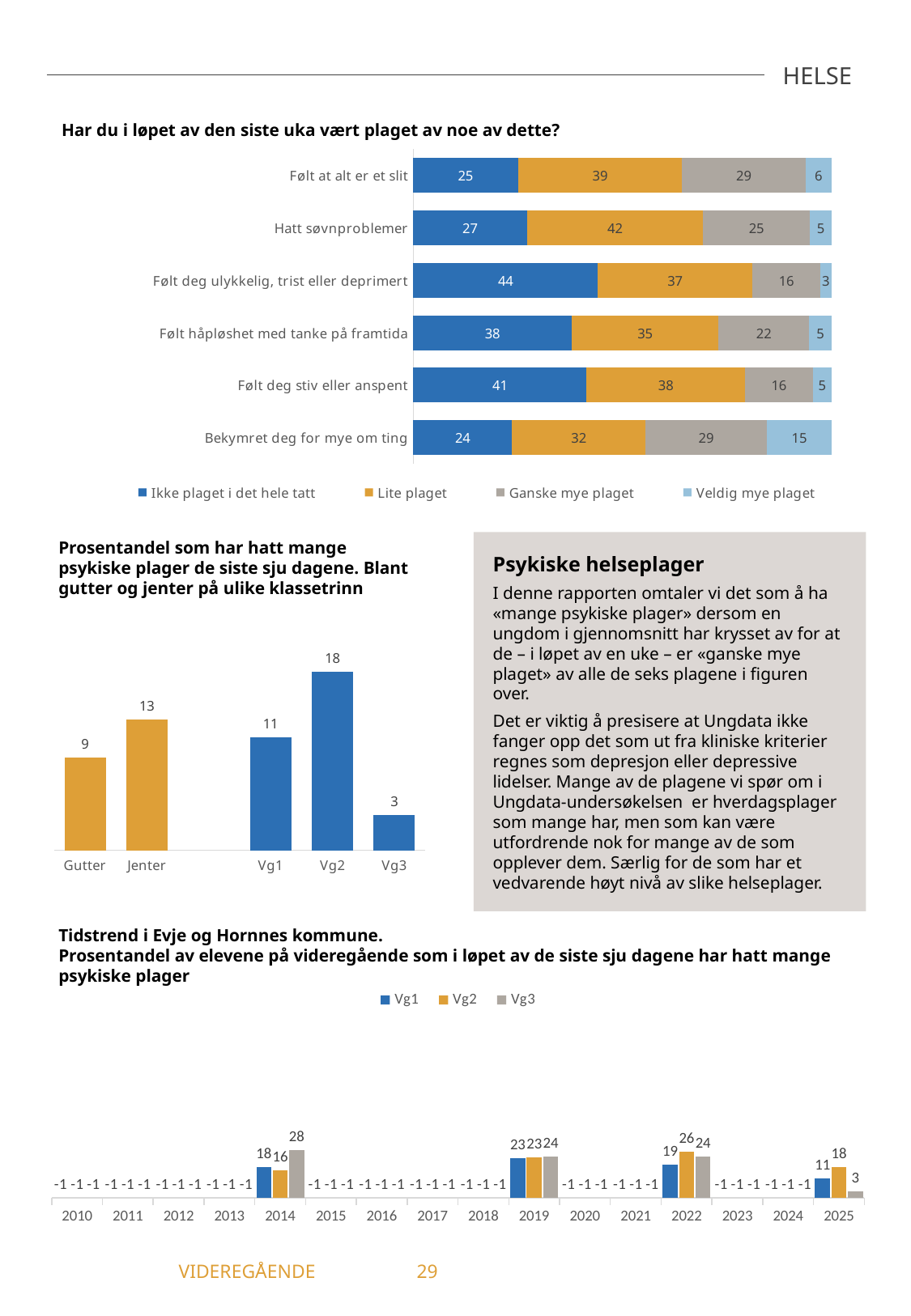
In the top chart 'Har du i løpet av den siste uka vært plaget av noe av dette?', how many categories are shown? 6 In the middle-left chart 'Prosentandel som har hatt mange psykiske plager de siste sju dagene', which is larger, Gutter or Jenter? Jenter In the top chart 'Har du i løpet av den siste uka vært plaget av noe av dette?', what is the value for 'Veldig mye plaget' for 'Bekymret deg for mye om ting'? 15 In the bottom chart 'Tidstrend i Evje og Hornnes kommune', what is the value for Vg3 in 2014? 28 In the top chart 'Har du i løpet av den siste uka vært plaget av noe av dette?', which category has the highest value for 'Ikke plaget i det hele tatt'? Følt deg ulykkelig, trist eller deprimert What kind of chart is the bottom chart 'Tidstrend i Evje og Hornnes kommune'? Bar chart In the middle-left chart 'Prosentandel som har hatt mange psykiske plager de siste sju dagene', what is the value for Vg2? 18 In the top chart 'Har du i løpet av den siste uka vært plaget av noe av dette?', what is the difference between 'Ganske mye plaget' for 'Følt at alt er et slit' and for 'Følt deg stiv eller anspent'? 13 In the bottom chart 'Tidstrend i Evje og Hornnes kommune', what is the difference between Vg2 and Vg3 in 2025? 15 In the top chart 'Har du i løpet av den siste uka vært plaget av noe av dette?', how many series does the legend list? 4 In the top chart 'Har du i løpet av den siste uka vært plaget av noe av dette?', what is the value for 'Lite plaget' for 'Hatt søvnproblemer'? 42 In the middle-left chart 'Prosentandel som har hatt mange psykiske plager de siste sju dagene', which category has the lowest value? Vg3